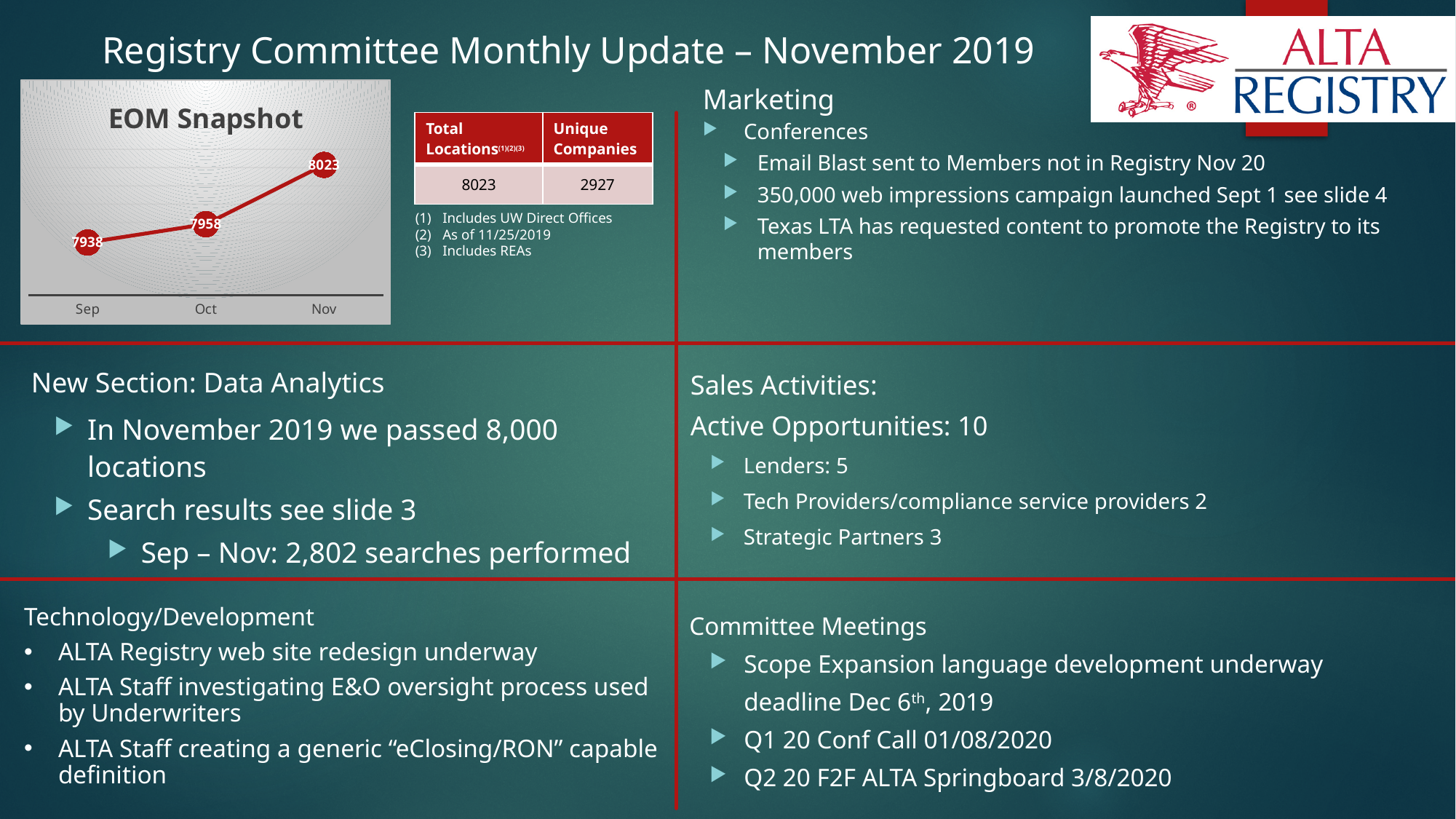
What is the difference between the Nov and Sep values in the EOM Snapshot chart? 85 What kind of chart is the EOM Snapshot? line chart What is the difference between the Oct and Sep values in the EOM Snapshot chart? 20 What is the value for Nov in the EOM Snapshot chart? 8023 What is the title of the chart on the slide? EOM Snapshot Which month has the highest value in the EOM Snapshot chart? Nov Which month has the lowest value in the EOM Snapshot chart? Sep What is the value for Sep in the EOM Snapshot chart? 7938 How many data points are plotted in the EOM Snapshot chart? 3 In the EOM Snapshot chart, is the value for Nov larger or smaller than the value for Oct? larger What is the value for Oct in the EOM Snapshot chart? 7958 Do the values in the EOM Snapshot chart rise or fall from Sep to Nov? rise